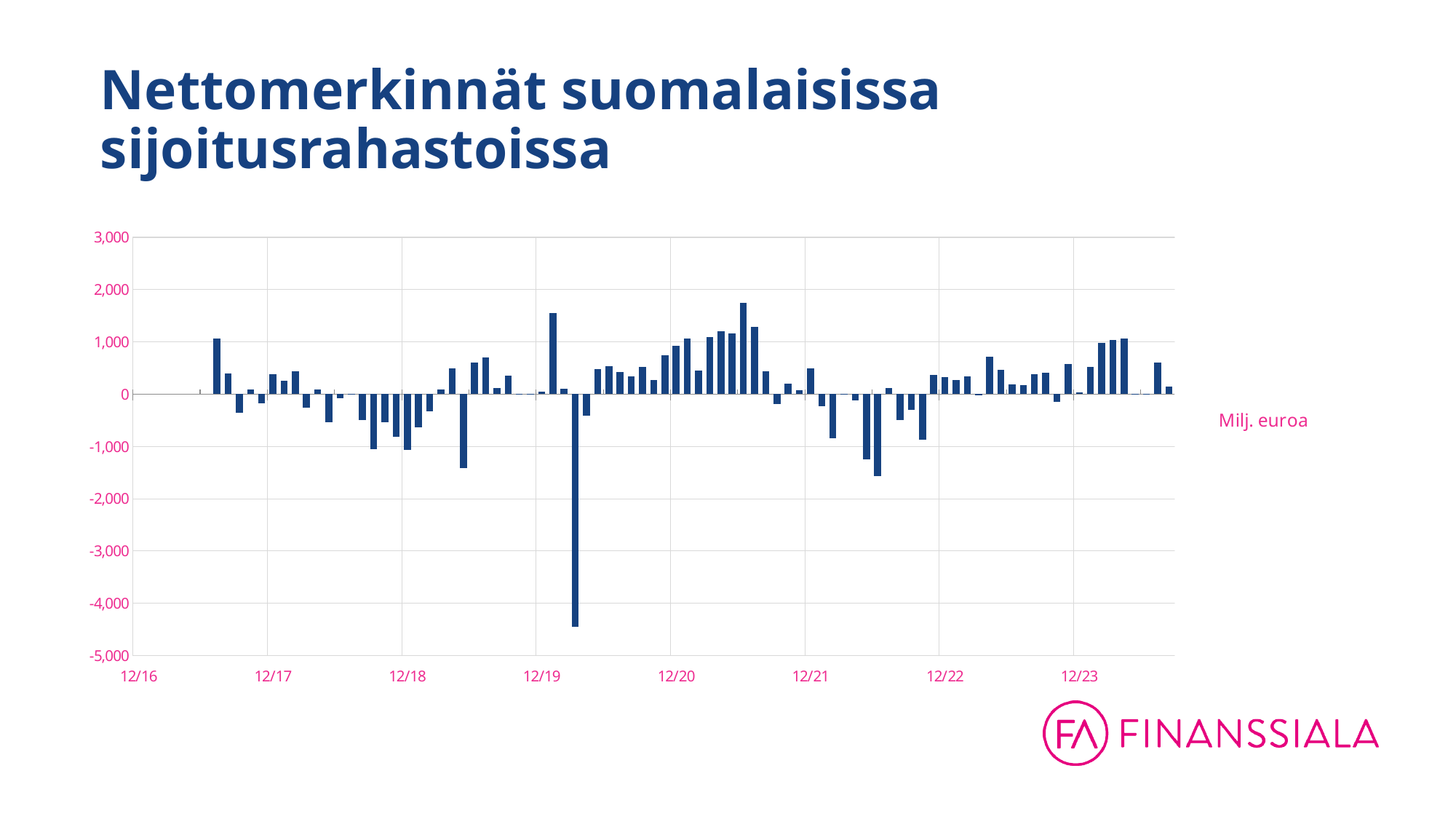
What kind of chart is shown on the slide? bar chart What is the lowest value shown on the y axis of the chart? -5,000 Between which two x-axis labels does the lowest bar of the chart fall? 12/19 and 12/20 Is the tallest positive bar in the chart (between 12/20 and 12/21) greater or less than 2,000? less What unit is indicated next to the chart? Milj. euroa Is the lowest bar in the chart (shortly after 12/19) greater or less than -4,000? less Is the tallest positive bar in the chart (between 12/20 and 12/21) greater or less than 1,000? greater How many date labels are shown on the x axis of the chart? 8 What is the title of the chart on the slide? Nettomerkinnät suomalaisissa sijoitusrahastoissa Between which two x-axis labels does the tallest positive bar of the chart fall? 12/20 and 12/21 Which is larger in absolute size: the lowest bar shortly after 12/19 or the tallest positive bar between 12/20 and 12/21? the lowest bar shortly after 12/19